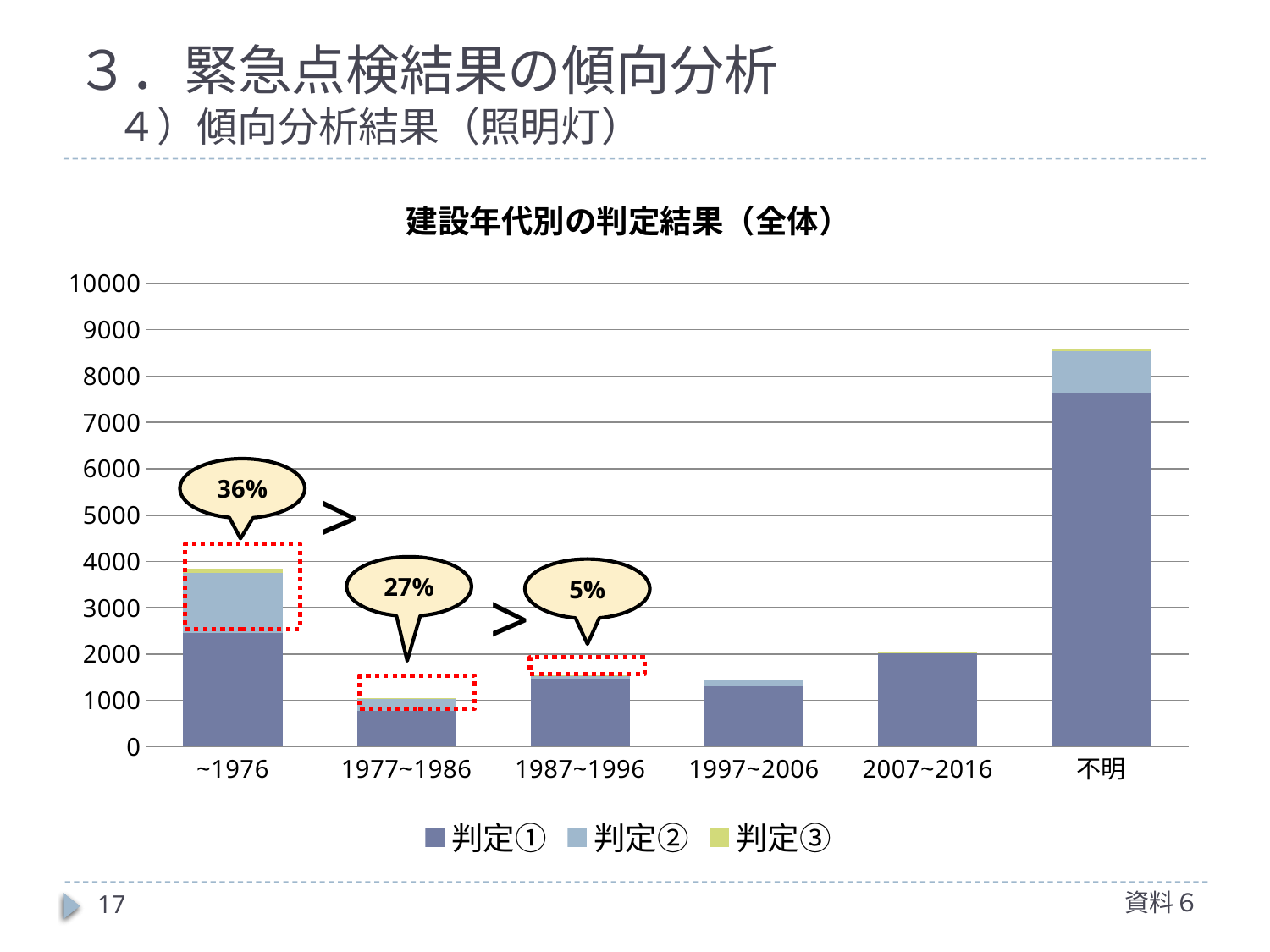
How many series does the legend list? 3 Is the 判定① value for 不明 greater or less than 7000? greater What is the title of the chart? 建設年代別の判定結果（全体） Which category has the tallest bar overall? 不明 Is the total bar height for 不明 greater or less than 8000? greater How many construction-period categories are shown on the x axis? 6 What type of chart is shown on the slide? stacked bar chart Which bar is taller overall, ~1976 or 2007~2016? ~1976 Is the total bar height for 1977~1986 greater or less than 2000? less What percentage is shown in the callout above the ~1976 bar? 36% Which category has the shortest bar overall? 1977~1986